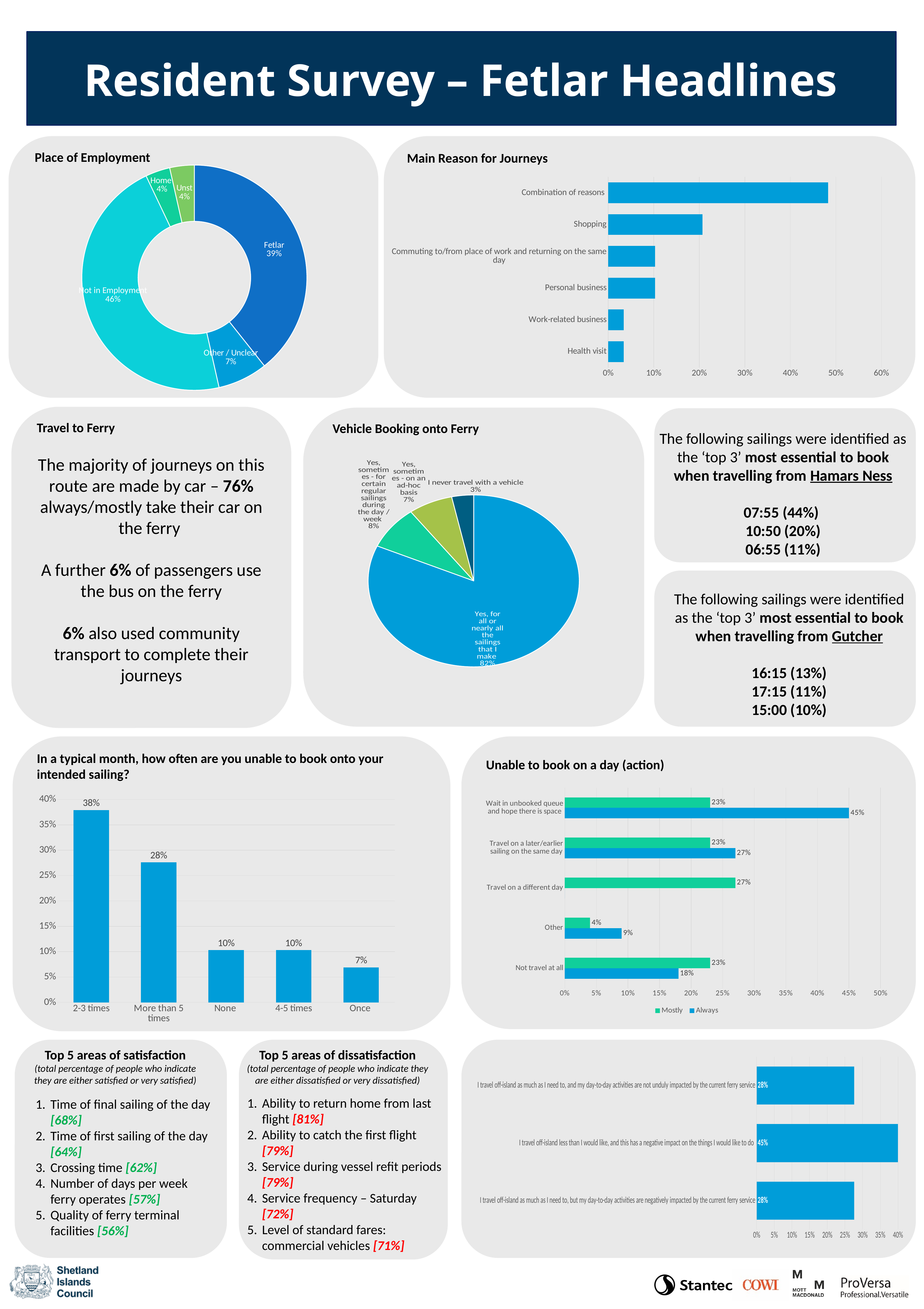
In the bottom-right bar chart, what is the value for 'I travel off-island less than I would like, and this has a negative impact on the things I would like to do'? 45% In the Unable to book on a day (action) chart, what is the Always value for 'Wait in unbooked queue and hope there is space'? 45% In the Main Reason for Journeys chart, which reason has the highest value? Combination of reasons In the chart 'In a typical month, how often are you unable to book onto your intended sailing?', what is the value for 2-3 times? 38% In the Main Reason for Journeys chart, is the value for Shopping greater or less than 30%? less In the Place of Employment chart, which category has the largest share? Not in Employment In the Vehicle Booking onto Ferry chart, what percentage never travel with a vehicle? 3% How many series does the legend of the Unable to book on a day (action) chart list? 2 In the chart 'In a typical month, how often are you unable to book onto your intended sailing?', which category has the lowest value? Once In the chart 'In a typical month, how often are you unable to book onto your intended sailing?', what is the difference between 2-3 times and More than 5 times? 10% In the Place of Employment chart, what share of respondents are Not in Employment? 46% How many reasons are listed in the Main Reason for Journeys chart? 6